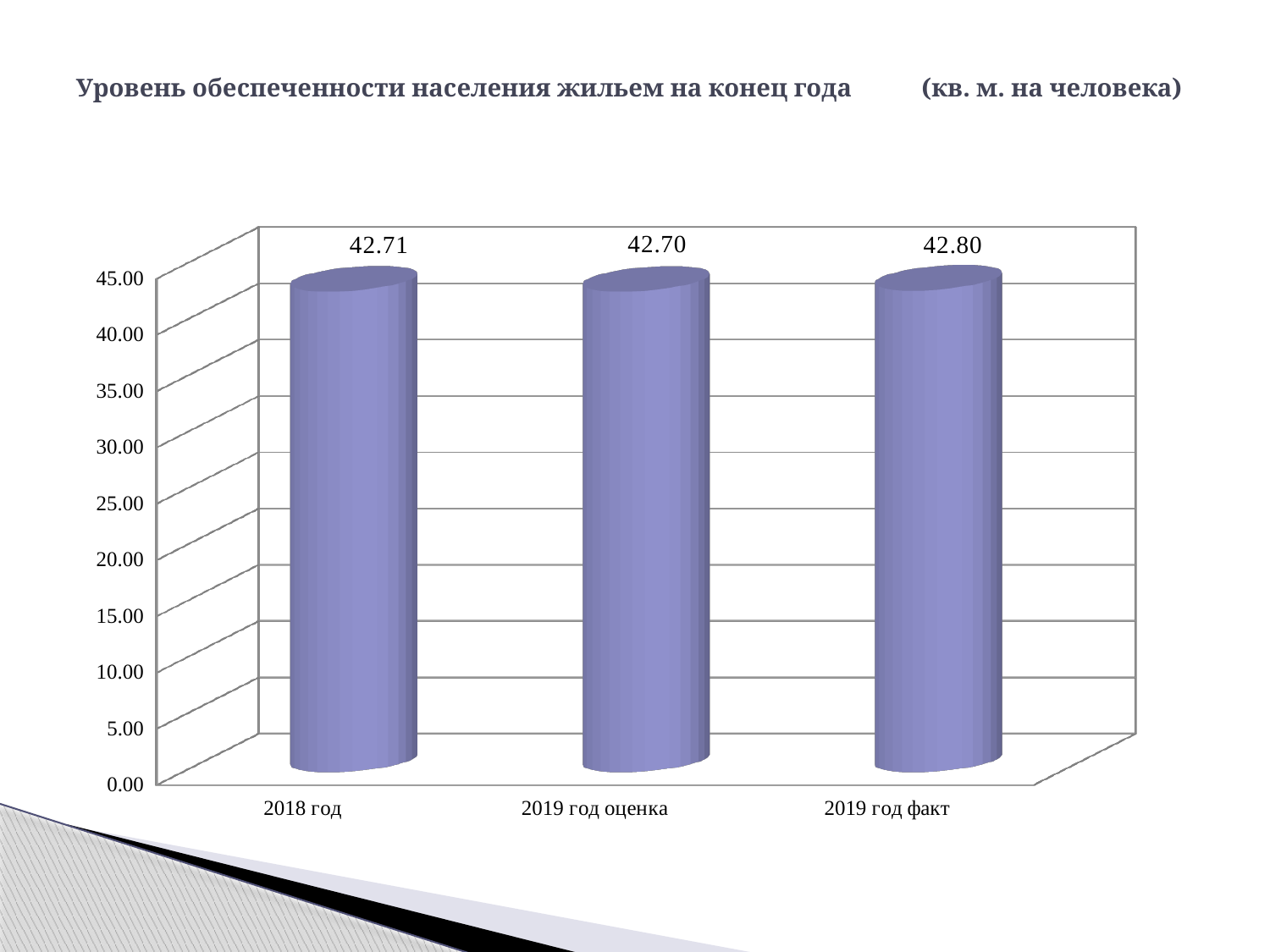
Which category has the highest value according to the data labels? 2019 год факт What is the title of the chart? Уровень обеспеченности населения жильем на конец года (кв. м. на человека) What is the value for 2019 год оценка? 42.70 What is the difference between the values for 2019 год факт and 2019 год оценка? 0.10 What kind of chart is shown on the slide? bar chart What is the value for 2018 год? 42.71 What is the value for 2019 год факт? 42.80 What is the difference between the values for 2019 год факт and 2018 год? 0.09 According to the data labels, which is larger: the value for 2019 год факт or the value for 2018 год? 2019 год факт Is the value for 2018 год greater or less than 40.00? greater How many categories are shown on the x axis? 3 Which category has the lowest value according to the data labels? 2019 год оценка